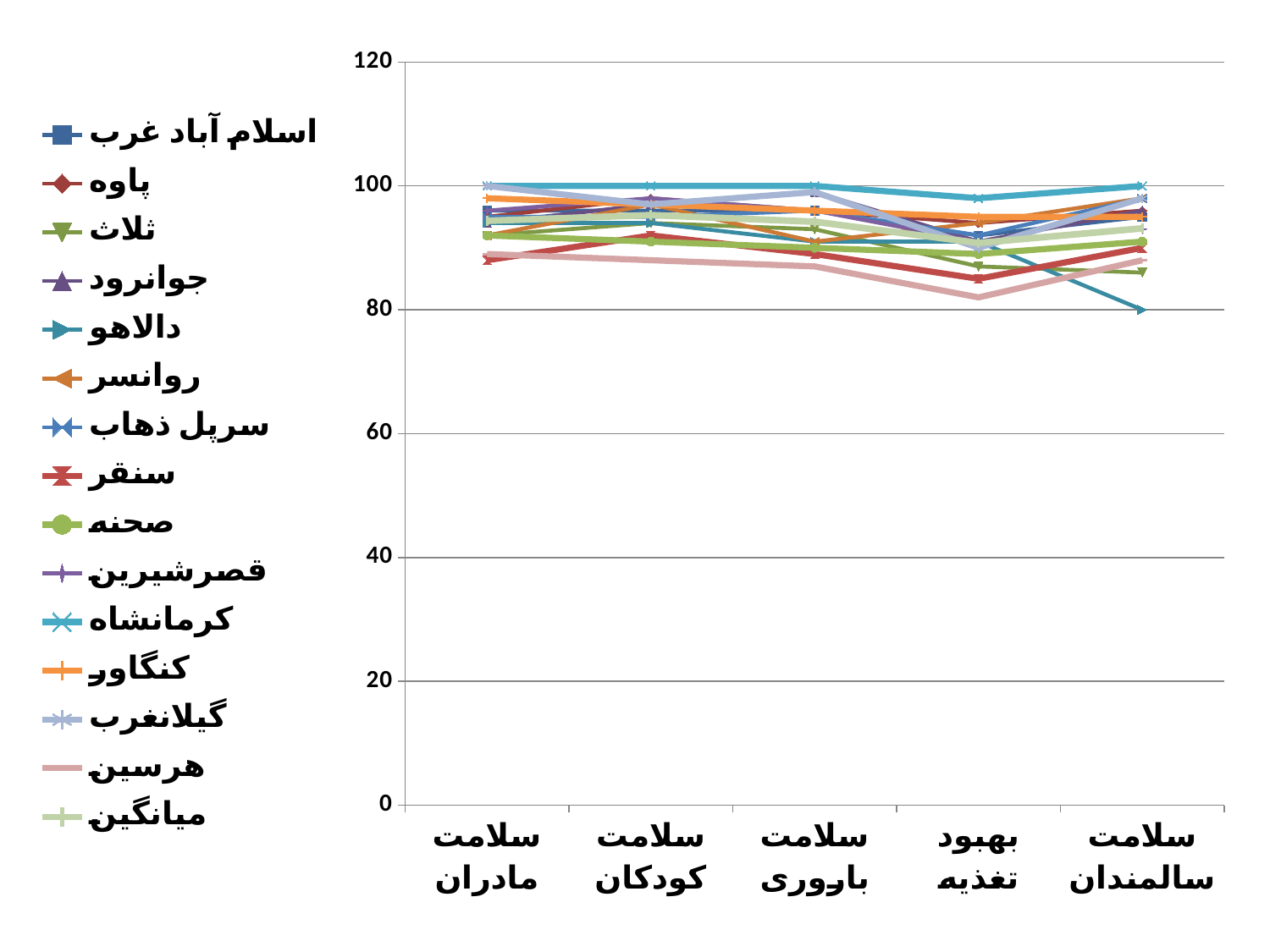
Which legend entry is listed last? میانگین How many categories are shown on the x axis? 5 At سلامت سالمندان, which is larger: کرمانشاه or دالاهو? کرمانشاه What kind of chart is shown on the slide? line chart What is the value for کرمانشاه at سلامت مادران? 100 Which series has the lowest value at بهبود تغذیه? هرسین What is the value for دالاهو at سلامت سالمندان? 80 Which series has the highest value at سلامت سالمندان? کرمانشاه Does the line for دالاهو rise or fall from سلامت مادران to سلامت سالمندان? fall How many series does the legend list? 15 Is the value for هرسین at بهبود تغذیه greater or less than 60? greater Which series has the lowest value at سلامت سالمندان? دالاهو